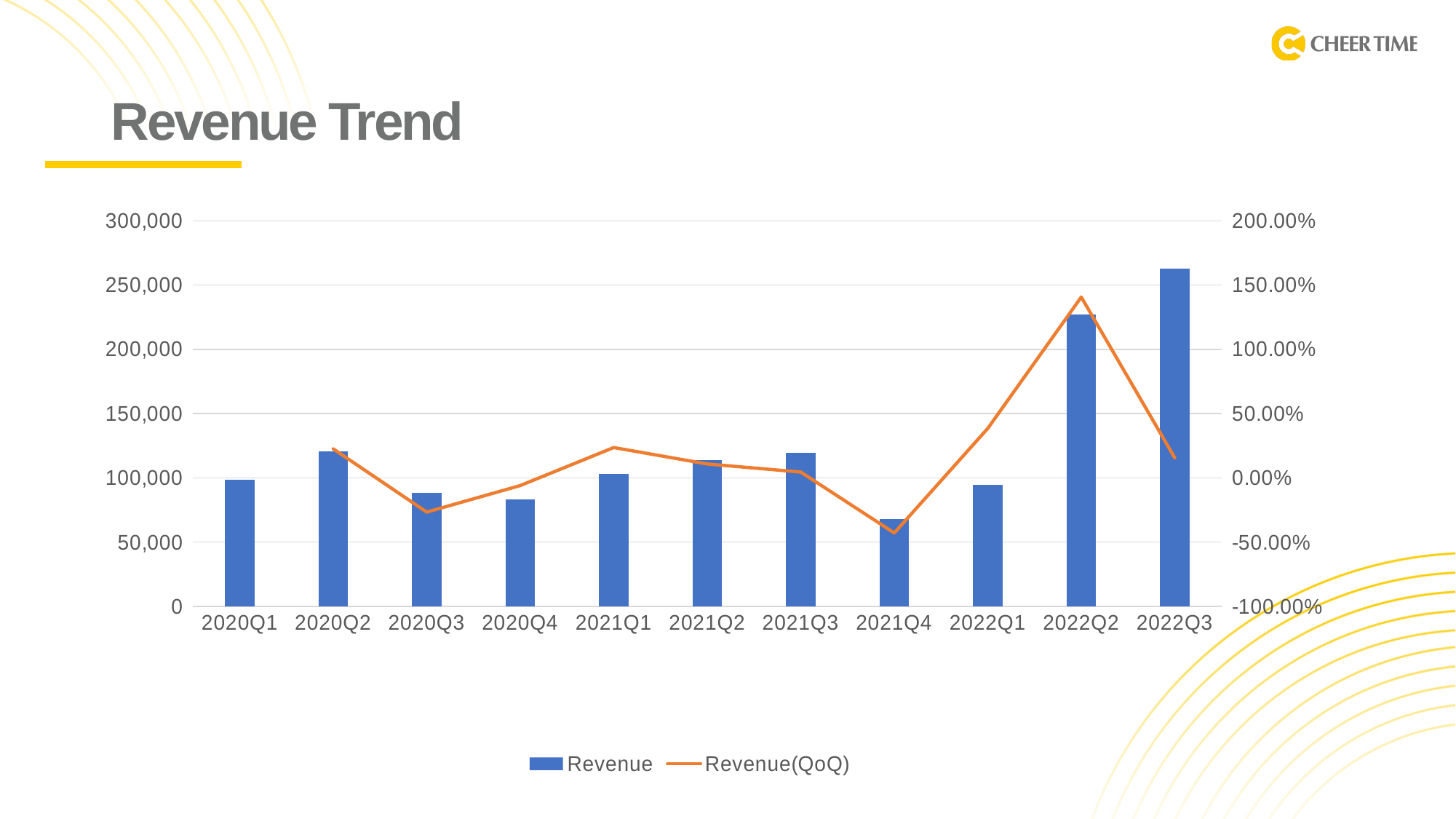
What is the title of the chart? Revenue Trend How many series does the legend list? 2 Does Revenue rise or fall from 2022Q1 to 2022Q3? rise Is the Revenue(QoQ) value for 2021Q4 greater or less than 0.00%? less Which is larger, the Revenue for 2022Q2 or for 2021Q3? 2022Q2 Is the Revenue(QoQ) value for 2022Q2 greater or less than 100.00%? greater What kind of chart is shown on the slide? A combined bar and line chart Which quarter has the highest Revenue bar? 2022Q3 Which quarter has the lowest Revenue bar? 2021Q4 Is the Revenue for 2021Q4 greater or less than 100,000? less How many quarters are shown on the x axis? 11